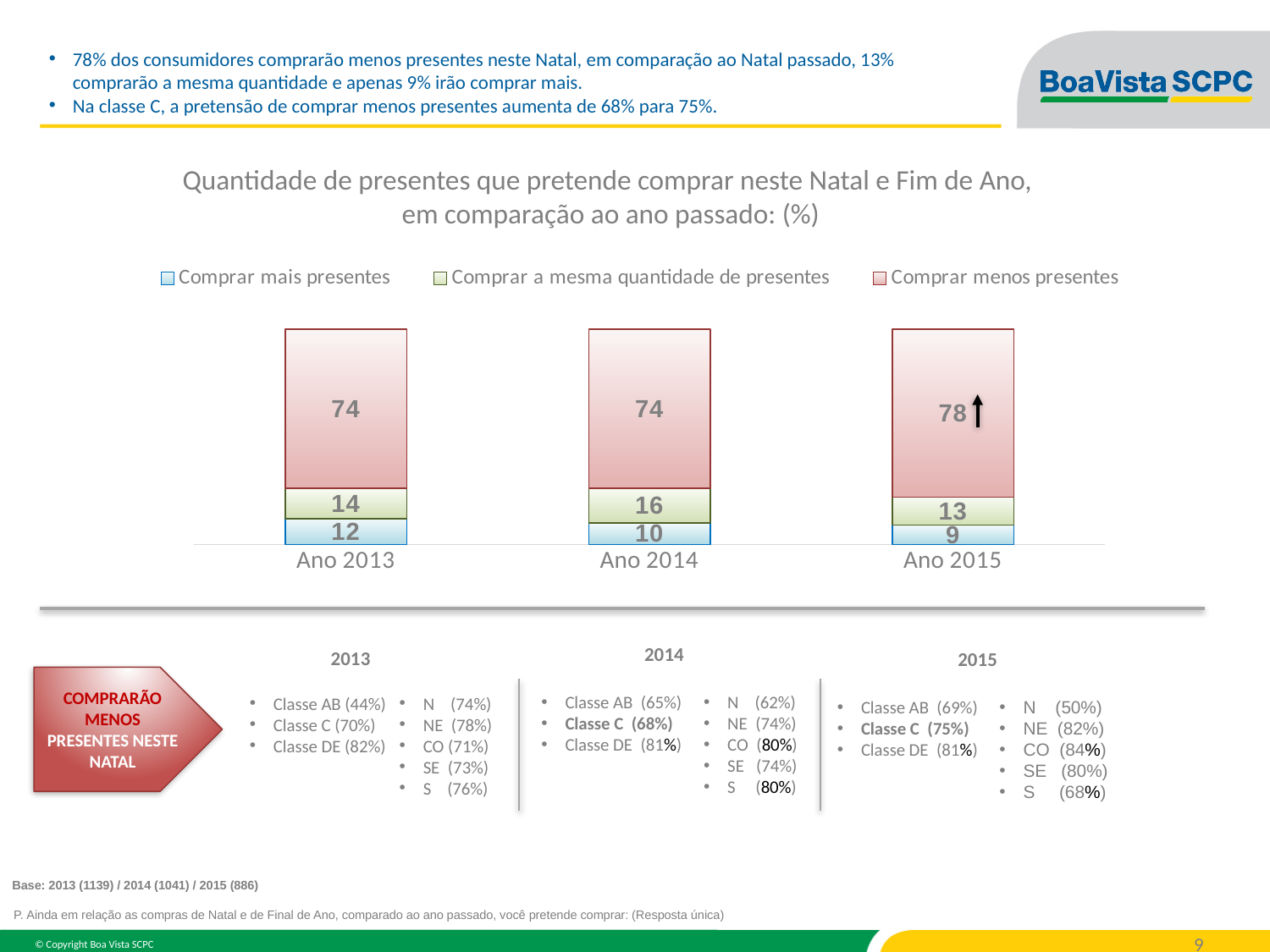
What is the value for "Comprar menos presentes" in Ano 2015? 78 What is the total of the stacked bar for Ano 2014? 100 In which year is the value for "Comprar mais presentes" lowest? Ano 2015 In which year is the value for "Comprar menos presentes" highest? Ano 2015 What kind of chart is shown on the slide? Stacked bar chart What is the value for "Comprar mais presentes" in Ano 2013? 12 What is the value for "Comprar a mesma quantidade de presentes" in Ano 2014? 16 What is the difference between the "Comprar menos presentes" values for Ano 2015 and Ano 2014? 4 How many series does the chart legend list? 3 Does the value for "Comprar mais presentes" rise or fall from Ano 2013 to Ano 2015? Fall Which is larger: "Comprar a mesma quantidade de presentes" in Ano 2014 or in Ano 2013? Ano 2014 How many years are shown on the x axis of the chart? 3